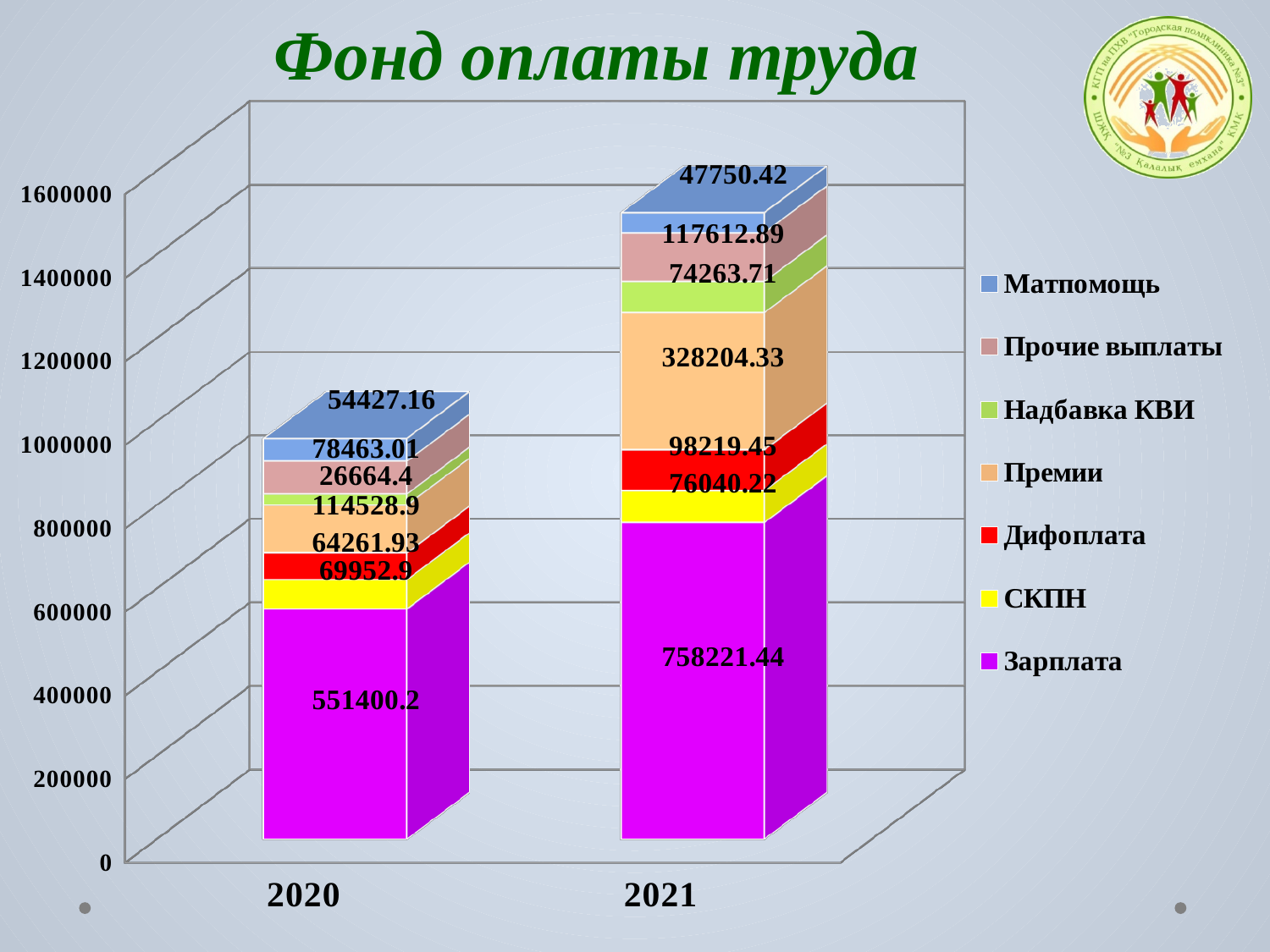
What is the value of Надбавка КВИ for 2021? 74263.71 What is the value of Премии for 2021? 328204.33 Which year has the larger value for Премии, 2020 or 2021? 2021 What is the title of the chart? Фонд оплаты труда What is the value of Зарплата for 2020? 551400.2 What is the value of Прочие выплаты for 2020? 78463.01 What is the value of Зарплата for 2021? 758221.44 By how much did Зарплата increase from 2020 to 2021? 206821.24 How many series does the legend list? 7 How many categories are shown on the x axis? 2 What is the value of Матпомощь for 2020? 54427.16 What kind of chart is shown on the slide? Stacked bar chart